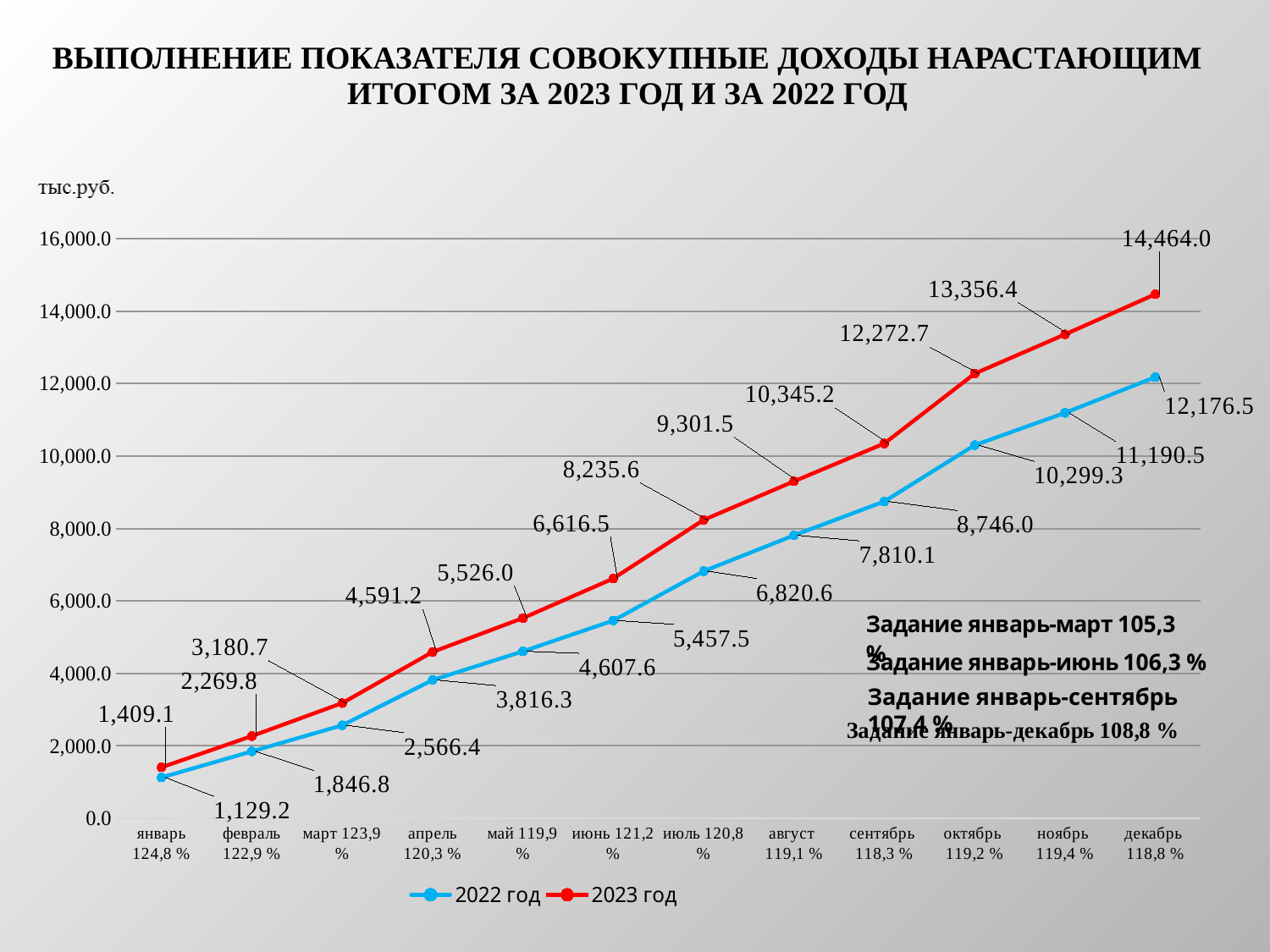
Which series has the larger value for июль, 2022 год or 2023 год? 2023 год What unit label is shown above the vertical axis? тыс.руб. What kind of chart is shown on the slide? line chart Do the values of the 2023 год series rise or fall from январь to декабрь? rise What is the value for сентябрь in the 2022 год series? 8,746.0 How many months are plotted along the x axis? 12 How many series does the legend list? 2 Which month has the lowest value in the 2022 год series? январь What is the value for декабрь in the 2023 год series? 14,464.0 What is the value for декабрь in the 2022 год series? 12,176.5 What is the difference between the 2023 год and 2022 год values for декабрь? 2,287.5 What is the value for январь in the 2023 год series? 1,409.1